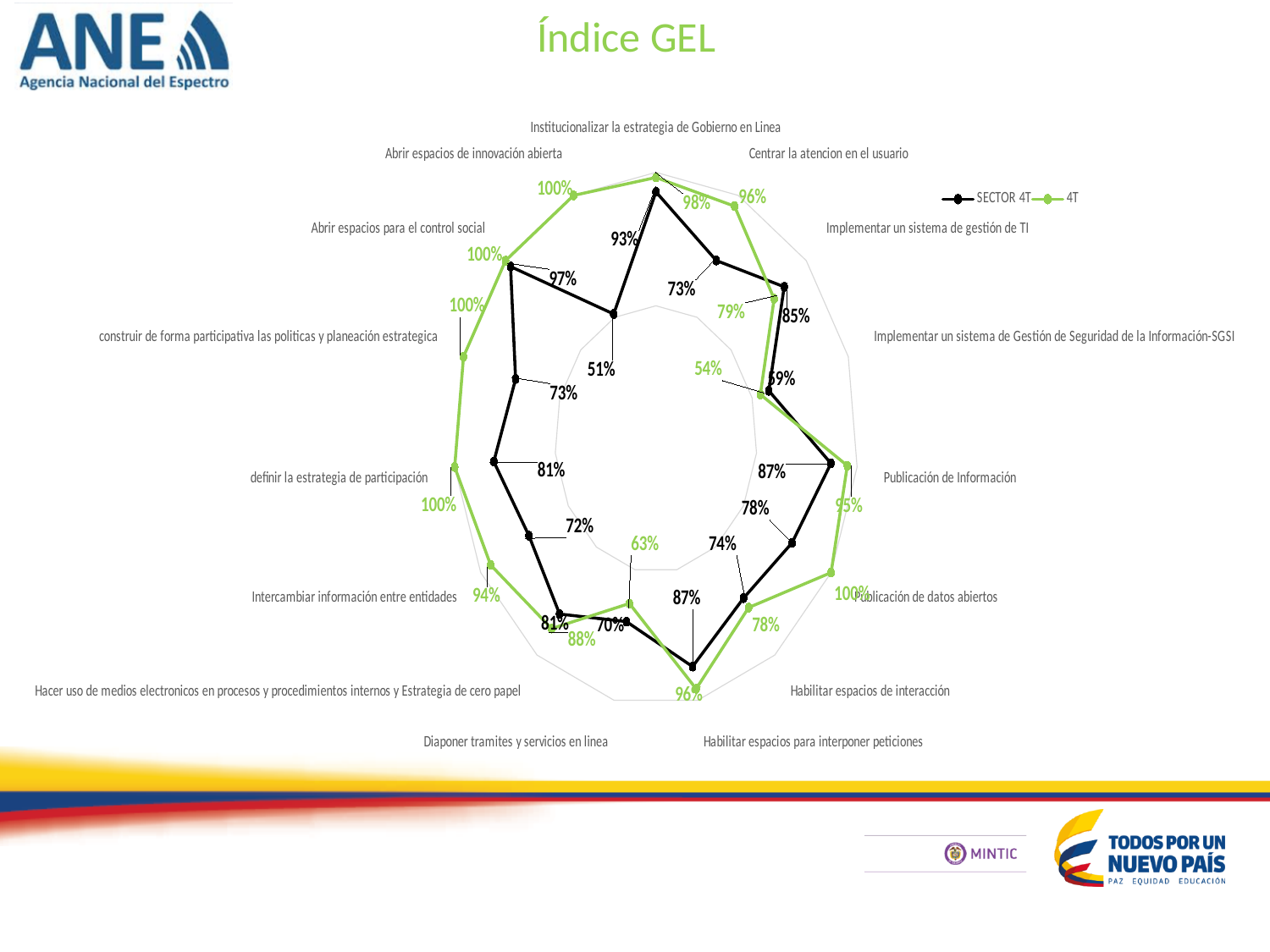
How many categories are plotted around the radar chart? 15 How many series does the legend list? 2 What is the SECTOR 4T value for Implementar un sistema de gestión de TI? 85% What kind of chart is shown on the slide? Radar chart For Publicación de Información, which series has the higher value, SECTOR 4T or 4T? 4T What is the 4T value for Publicación de datos abiertos? 100% What is the 4T value for Implementar un sistema de Gestión de Seguridad de la Información-SGSI? 54% Which category has the lowest 4T value? Implementar un sistema de Gestión de Seguridad de la Información-SGSI What is the difference between the 4T and SECTOR 4T values for Centrar la atencion en el usuario? 23 percentage points For Implementar un sistema de gestión de TI, which series has the higher value, SECTOR 4T or 4T? SECTOR 4T What are the two series named in the legend? SECTOR 4T and 4T What is the SECTOR 4T value for Institucionalizar la estrategia de Gobierno en Linea? 93%